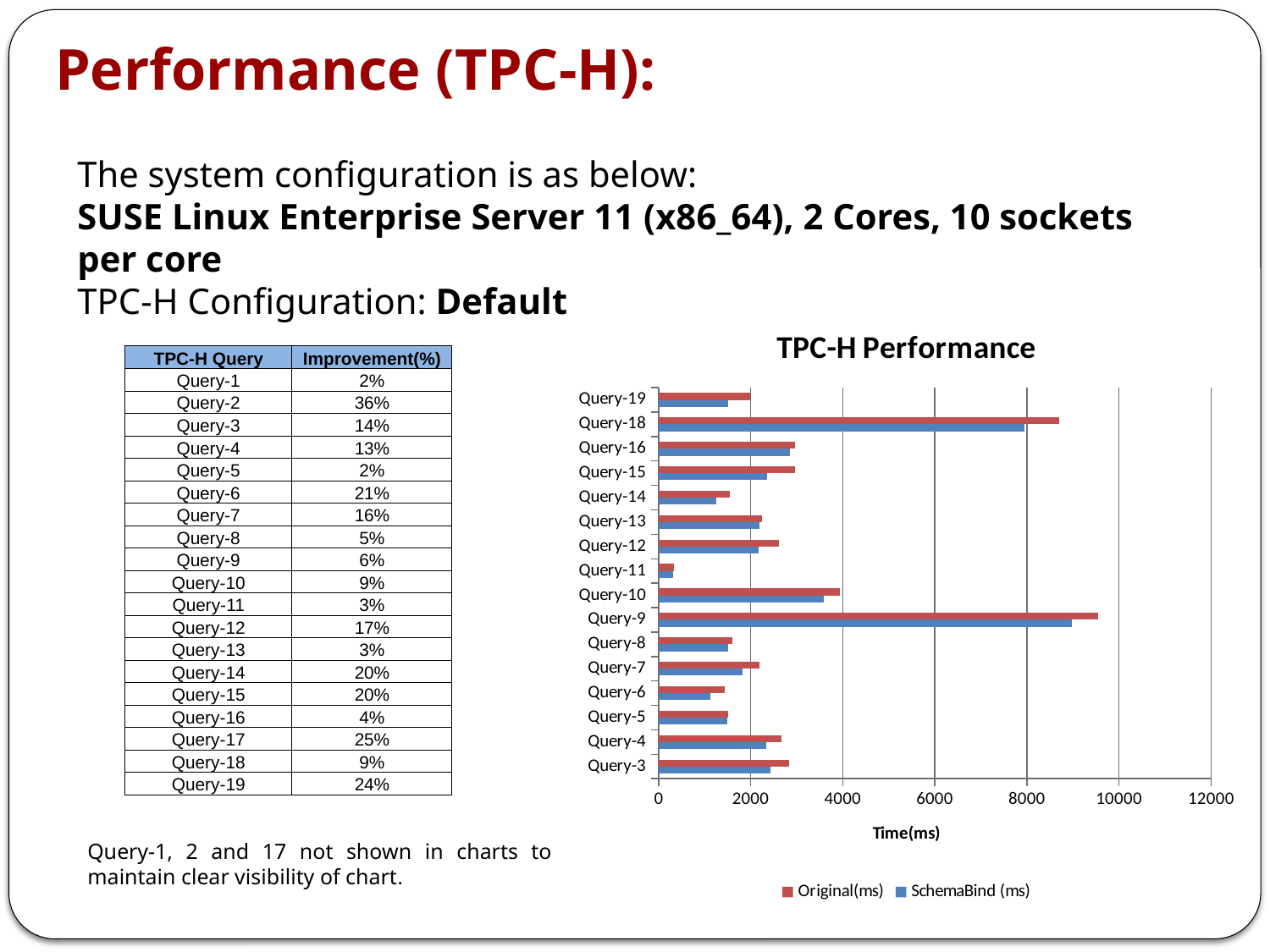
Is the Original(ms) value for Query-11 greater or less than 2000? less Is the Original(ms) value for Query-10 greater or less than 2000? greater How many queries are plotted on the TPC-H Performance chart? 16 Which is larger, the Original(ms) value for Query-9 or for Query-18? Query-9 How many series does the legend of the TPC-H Performance chart list? 2 Which series is shown in blue in the TPC-H Performance chart? SchemaBind (ms) What is the label of the horizontal axis of the TPC-H Performance chart? Time(ms) Which query has the highest Original(ms) value in the TPC-H Performance chart? Query-9 Which query has the lowest Original(ms) value in the TPC-H Performance chart? Query-11 For Query-9, which is larger, the Original(ms) value or the SchemaBind (ms) value? Original(ms) Is the Original(ms) value for Query-18 greater or less than 8000? greater What kind of chart is the TPC-H Performance chart? bar chart